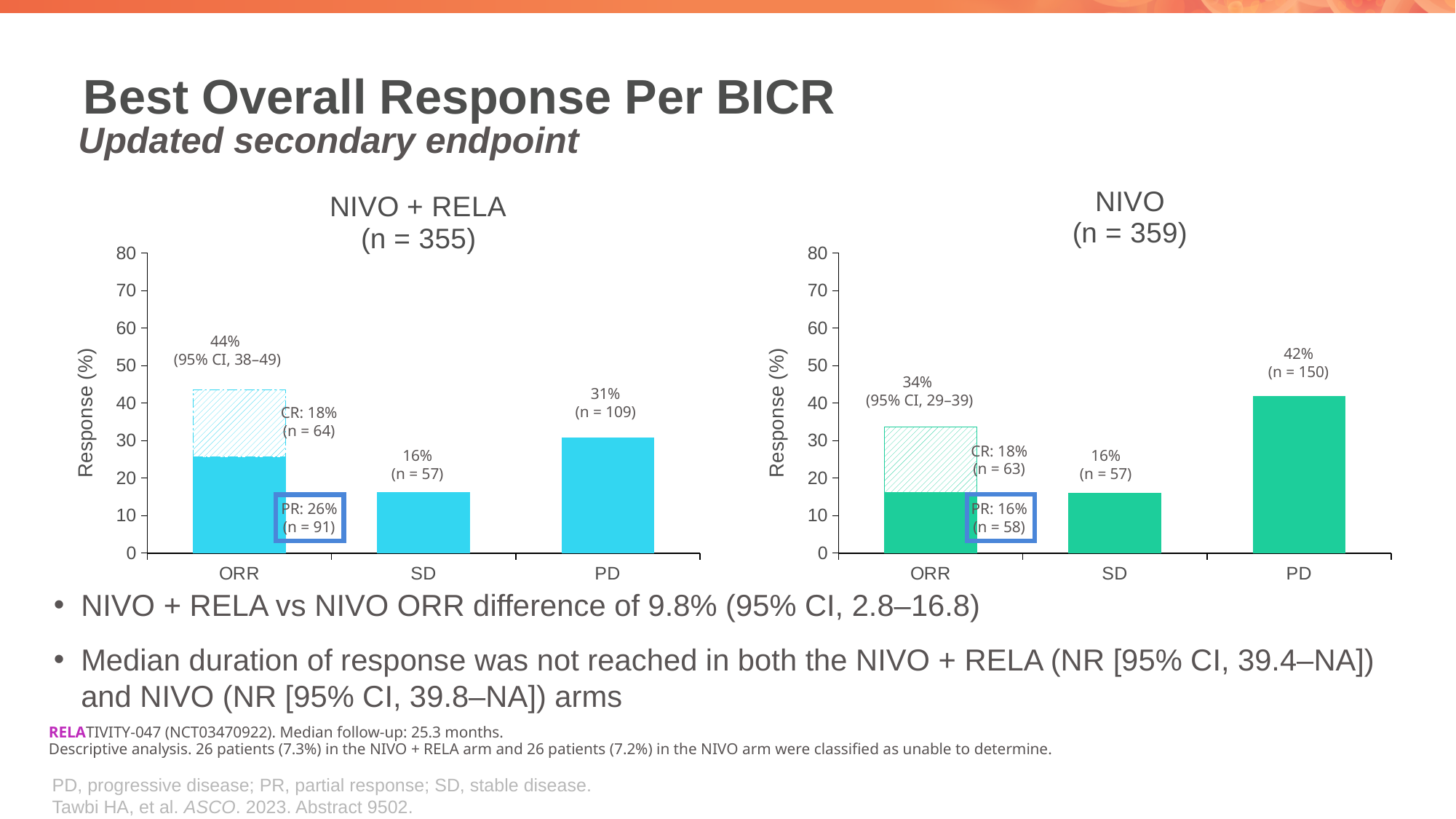
In the NIVO + RELA chart, is the ORR value or the PD value larger? ORR What kind of chart is the NIVO + RELA chart? bar chart In the NIVO + RELA chart, which category has the lowest value? SD What is the difference between the ORR value in the NIVO + RELA chart and the ORR value in the NIVO chart? 10% In the NIVO chart, what is the number of patients (n) for SD? 57 What is the sample size (n) shown in the title of the NIVO chart? 359 In the NIVO + RELA chart, what is the ORR value? 44% In the NIVO chart, is the value for PD greater or less than 40? greater How many categories are shown on the x axis of the NIVO chart? 3 In the NIVO chart, which category has the highest value? PD In the NIVO chart, what is the PD value? 42% In the NIVO + RELA chart, what is the PR percentage shown for ORR? 26%